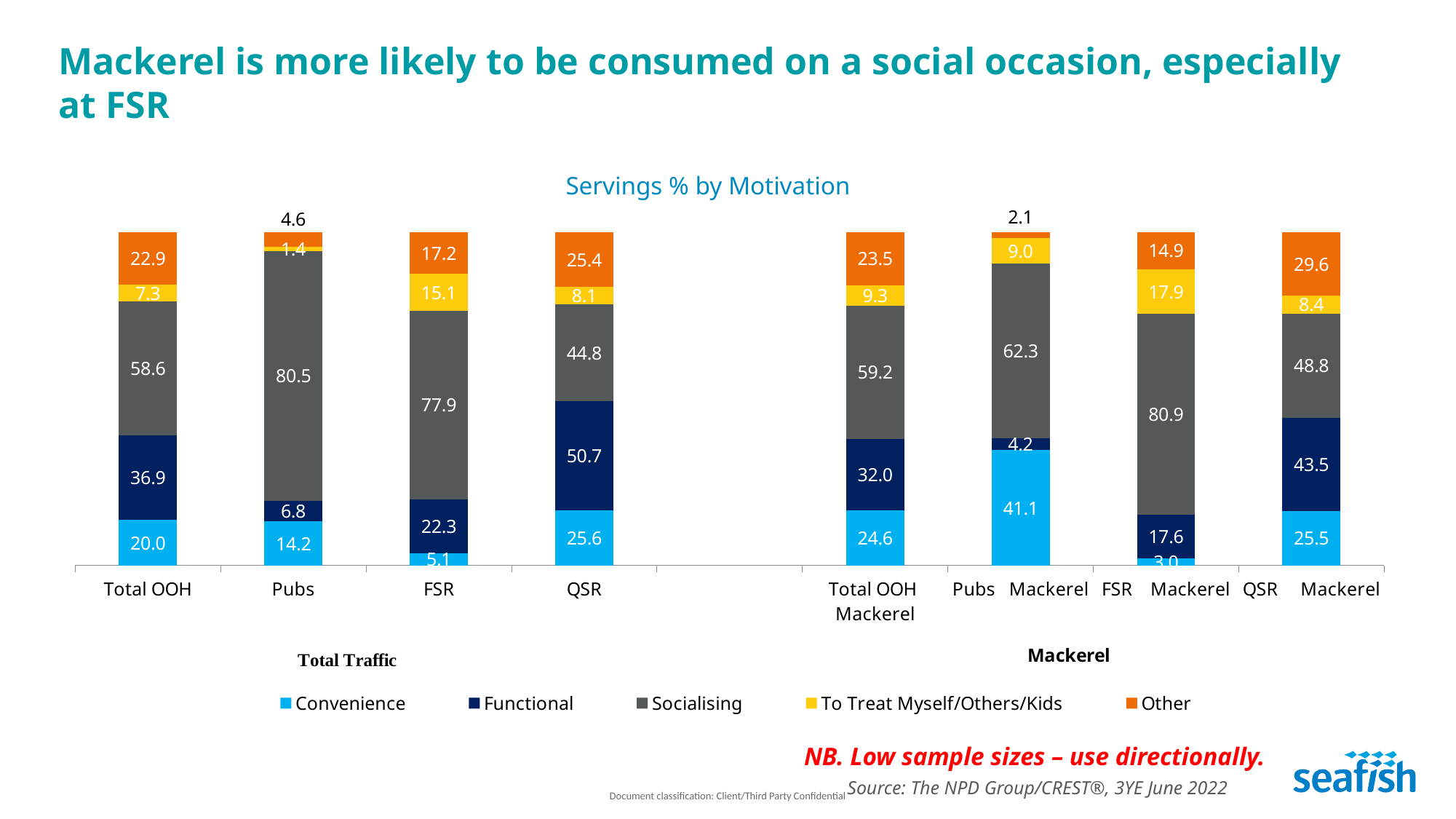
What is the To Treat Myself/Others/Kids value for Pubs? 1.4 How many series does the legend list? 5 Which category has the lowest Convenience value? FSR Mackerel What is the Functional value for QSR? 50.7 Which is larger, the Functional value for QSR or for QSR Mackerel? QSR What is the Other value for QSR Mackerel? 29.6 What is the Socialising value for FSR Mackerel? 80.9 How many categories (bars) are shown in the chart? 8 What is the Convenience value for Pubs Mackerel? 41.1 What is the difference between the Socialising values for FSR Mackerel and FSR? 3.0 Which category has the highest Convenience value? Pubs Mackerel What type of chart is shown on the slide? Stacked bar chart